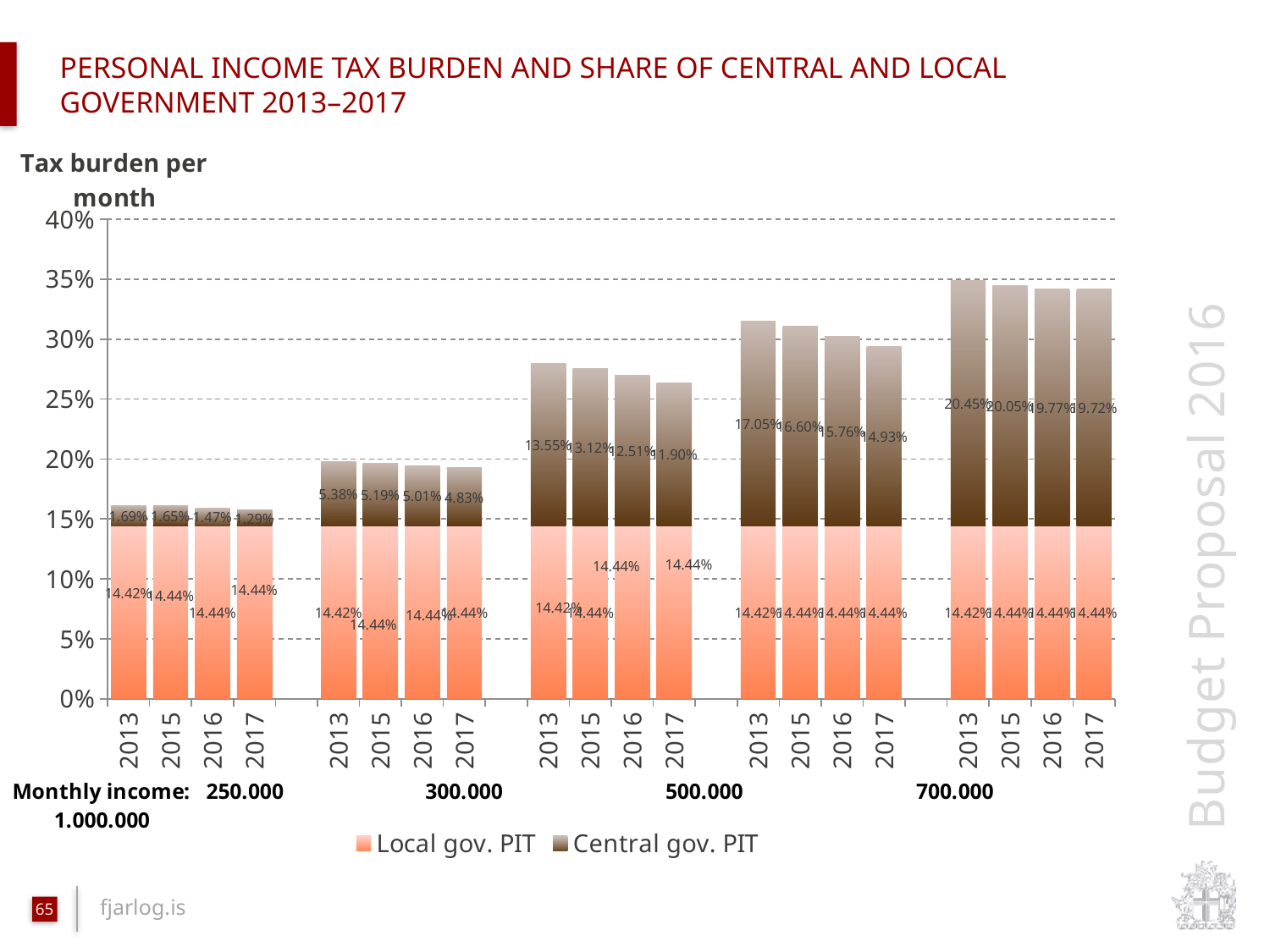
What is the Local gov. PIT value for 2013 at a monthly income of 700.000? 14.42% Which bar has the lowest Central gov. PIT value? 2017 at 250.000 What is the difference between the Central gov. PIT values for 2013 at 1.000.000 and 2013 at 250.000? 18.76 percentage points How many bars are plotted in the chart? 20 What is the total tax burden for 2013 at a monthly income of 1.000.000? 34.87% What is the Central gov. PIT value for 2013 at a monthly income of 250.000? 1.69% What is the Central gov. PIT value for 2017 at a monthly income of 500.000? 11.90% Is the total tax burden for 2013 at a monthly income of 700.000 greater or less than 30%? greater How many series does the legend list? 2 Which is larger: the Central gov. PIT value for 2015 at 700.000 or for 2015 at 500.000? 2015 at 700.000 What type of chart is shown on the slide? Stacked bar chart Which bar has the highest Central gov. PIT value? 2013 at 1.000.000